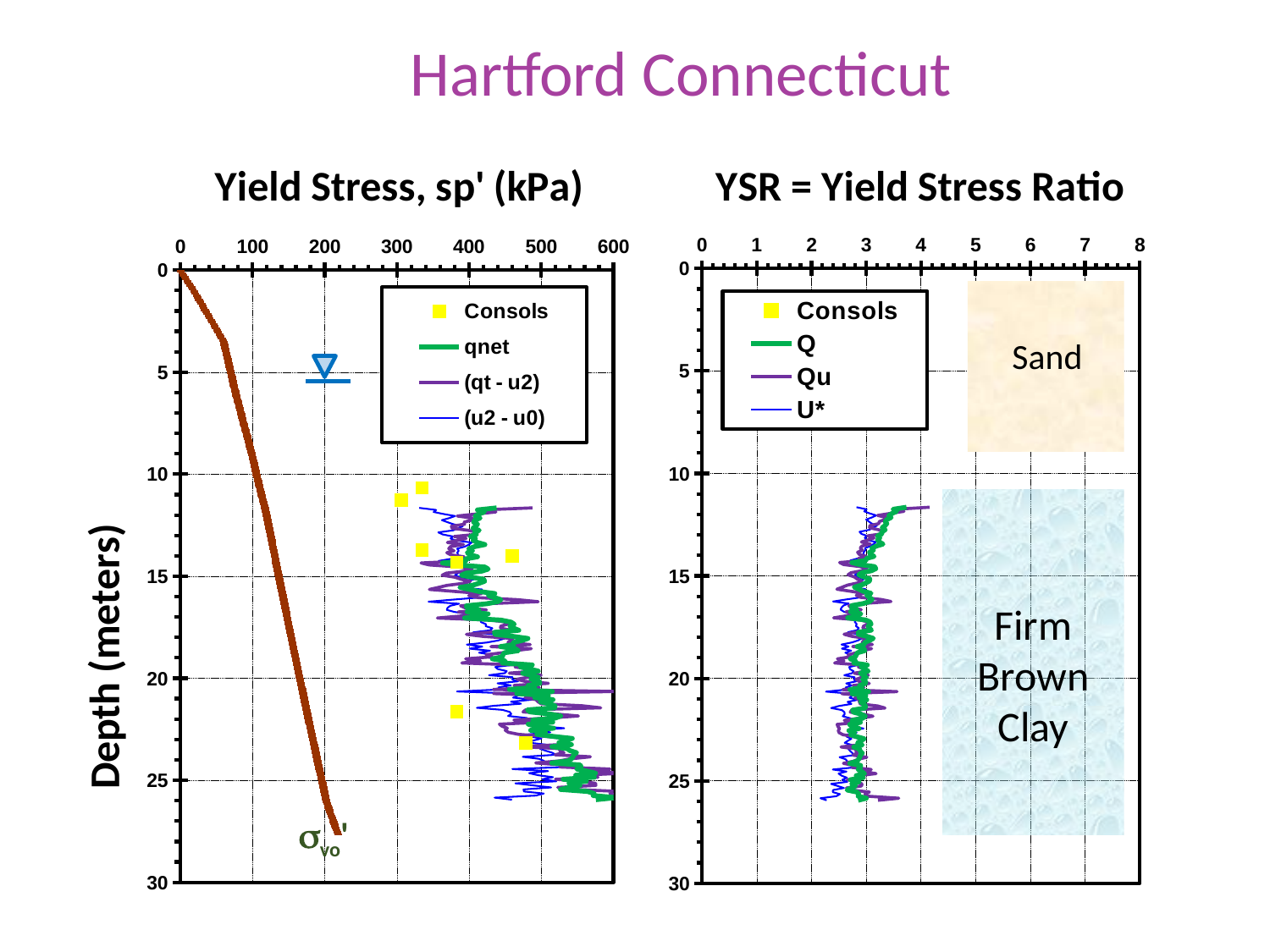
On the right chart, is the Q value at a depth of 20 meters greater or less than 2? greater On the right chart (YSR = Yield Stress Ratio), how many series does the legend list? 4 On the left chart, is the σvo' line at a depth of 25 meters greater or less than 300? less On the left chart, is the qnet value at a depth of 13 meters greater or less than 500? less On the left chart, how many series does the legend list? 4 What is the label of the shared y axis on the slide? Depth (meters) What is the highest value shown on the x axis of the right chart? 8 On the left chart, does the qnet value rise or fall as depth increases from 12 to 26 meters? rise What kind of chart is the left chart titled 'Yield Stress, sp' (kPa)'? line chart